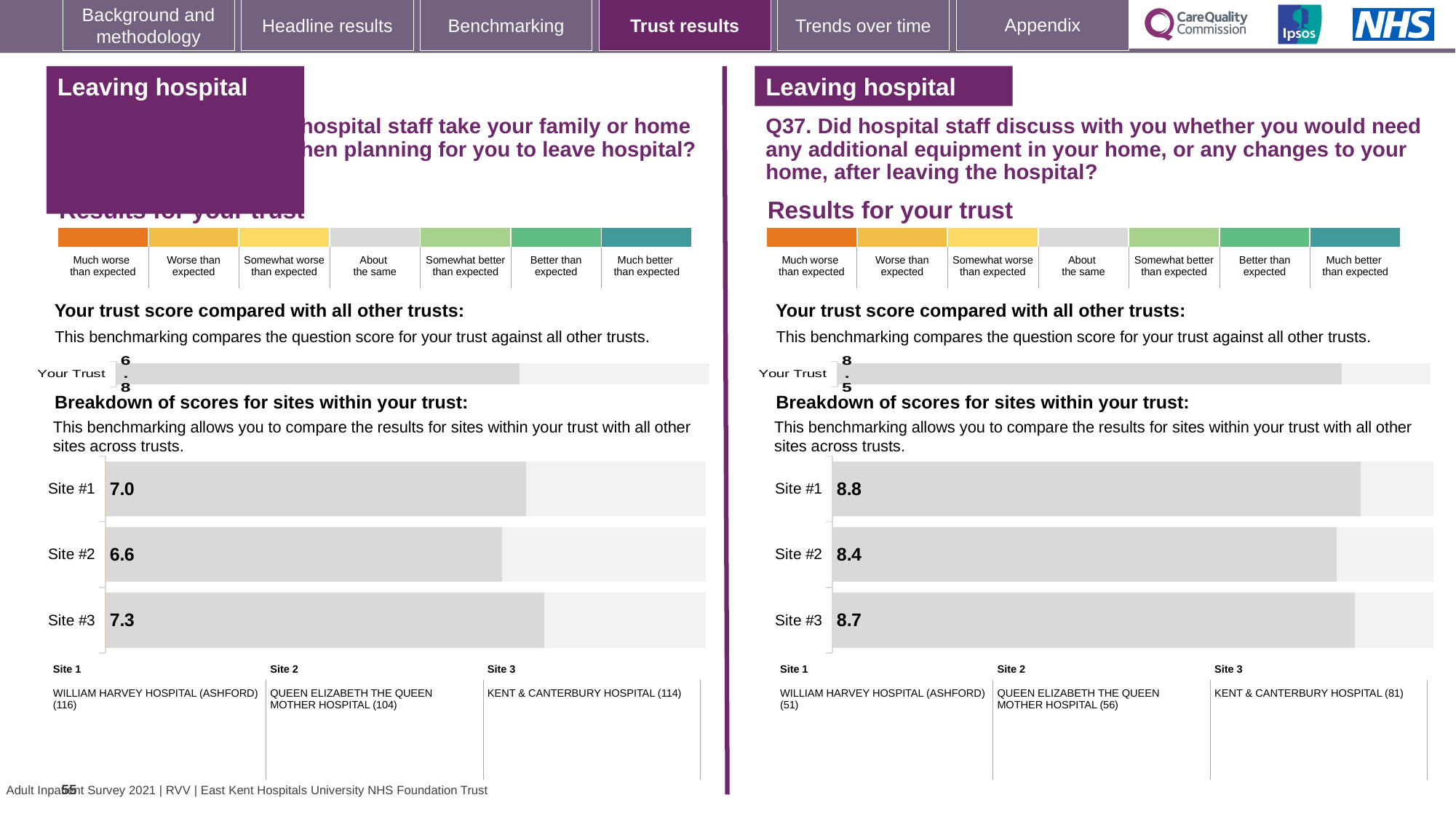
What kind of chart is used for the site breakdown on the left side of the slide? bar chart On the left chart's site breakdown, what is the difference between the scores for Site #3 and Site #2? 0.7 How many sites are shown in the site breakdown on the right chart (Q37)? 3 On the right chart (Q37), what is the score for Site #1? 8.8 On the left chart's site breakdown, what is the score for Site #1? 7.0 On the left chart's site breakdown, which site has the lowest score? Site #2 On the left chart's site breakdown, which site has the highest score? Site #3 On the left chart's site breakdown, what is the score for Site #2? 6.6 On the right chart (Q37), is the score for Site #2 larger or smaller than the score for Site #3? smaller On the right chart (Q37), which site has the lowest score? Site #2 On the right chart (Q37), what is the difference between the scores for Site #1 and Site #2? 0.4 On the right chart (Q37), what is the score for Site #3? 8.7